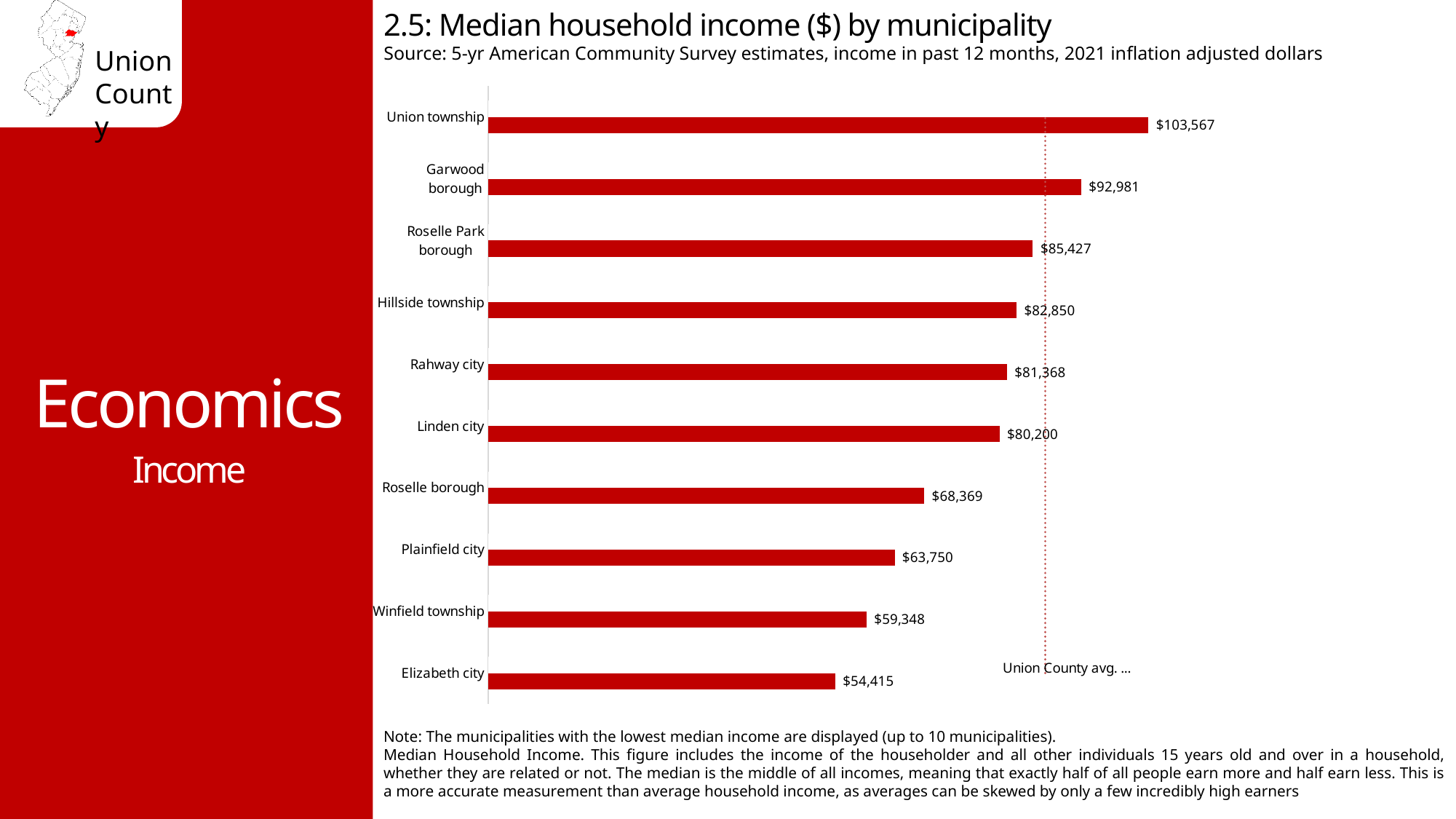
What kind of chart is shown on the slide? Bar chart What is the median household income for Rahway city? $81,368 What is the difference in median household income between Garwood borough and Roselle Park borough? $7,554 Which municipality has the highest median household income shown on the chart? Union township What does the dotted vertical line on the chart represent? Union County avg. What is the difference in median household income between Union township and Elizabeth city? $49,152 Which municipality has the lowest median household income shown on the chart? Elizabeth city What is the median household income for Union township? $103,567 How many municipalities are shown on the chart? 10 What is the median household income for Plainfield city? $63,750 Which has a higher median household income, Roselle borough or Winfield township? Roselle borough What is the median household income for Elizabeth city? $54,415